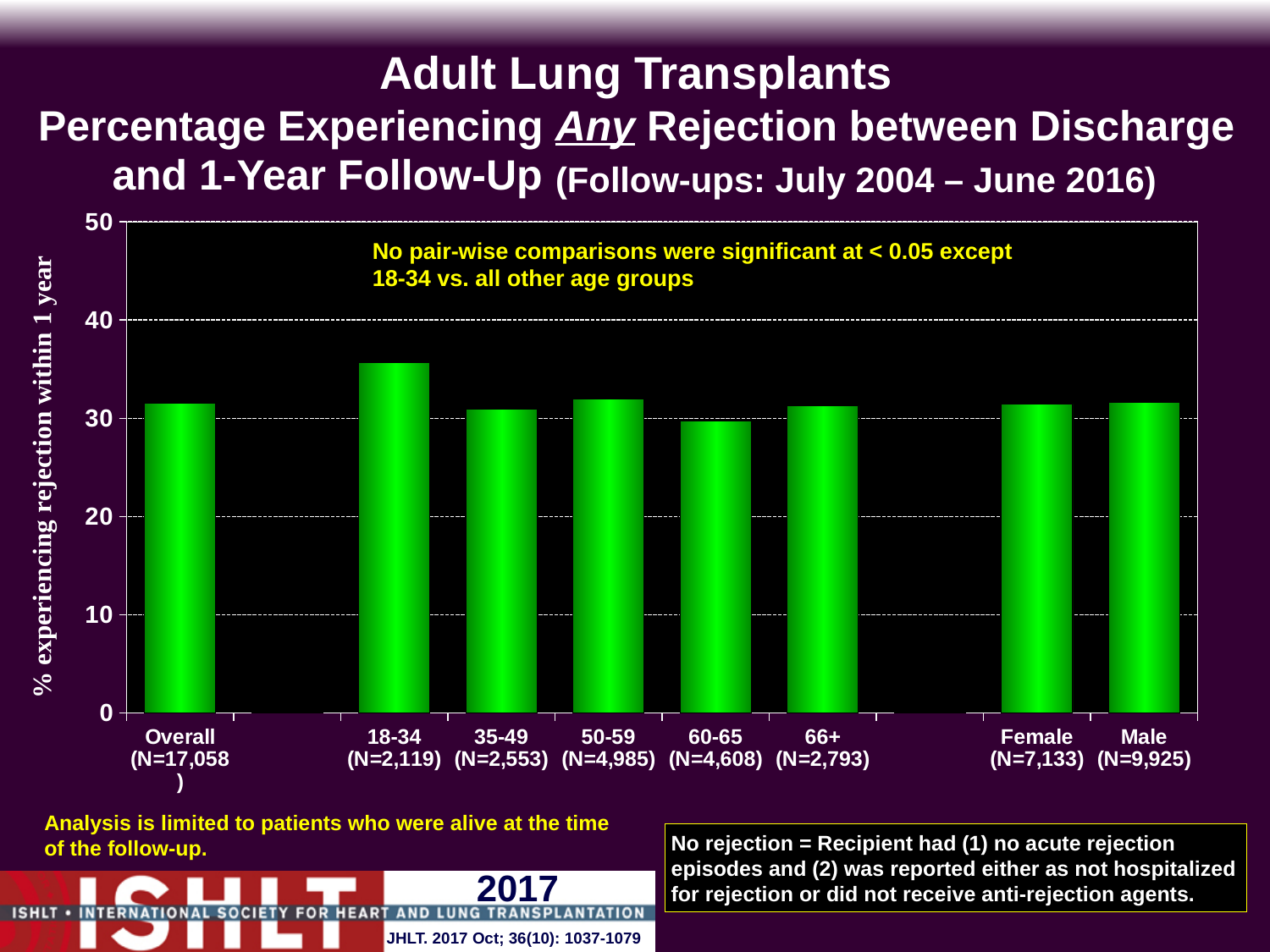
What kind of chart is shown on the slide? bar chart Which category has the lowest percentage experiencing rejection within 1 year? 60-65 Is the value for the 18-34 age group greater or less than 40? less Is the value for the Overall group greater or less than 20? greater Which has a higher percentage experiencing rejection: the 18-34 age group or the 50-59 age group? 18-34 What is the label of the y-axis? % experiencing rejection within 1 year According to the note on the chart, which age group's pair-wise comparisons were significant at < 0.05? 18-34 vs. all other age groups Is the value for the 60-65 age group greater or less than 40? less How many bars (categories) are plotted in the chart? 8 Which has a higher percentage experiencing rejection: the 18-34 age group or the 60-65 age group? 18-34 Which category has the highest percentage experiencing rejection within 1 year? 18-34